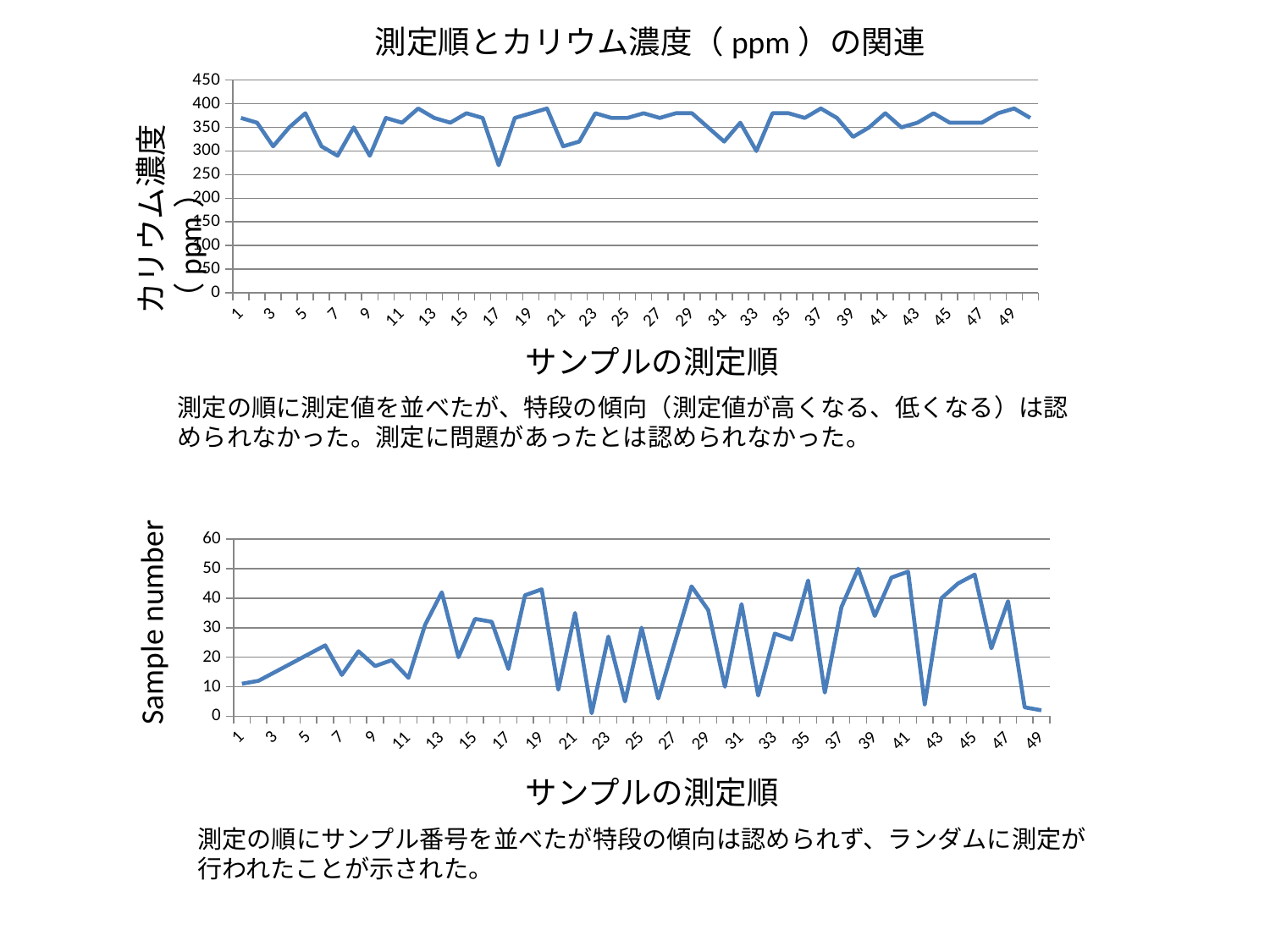
What is the y-axis label of the bottom chart? Sample number In the top chart, is the value at measurement order 13 greater or less than 350? greater In the bottom chart, is the value at measurement order 22 greater or less than 10? less What kind of chart is the bottom chart on the slide? line chart What is the title of the top chart? 測定順とカリウム濃度（ppm）の関連 In the bottom chart, is the value at measurement order 49 greater or less than 10? less In the top chart, at which measurement order is the potassium concentration lowest? 17 In the top chart, do the potassium concentration values show a clear rising or falling trend along the measurement order? no clear trend What kind of chart is the top chart on the slide? line chart